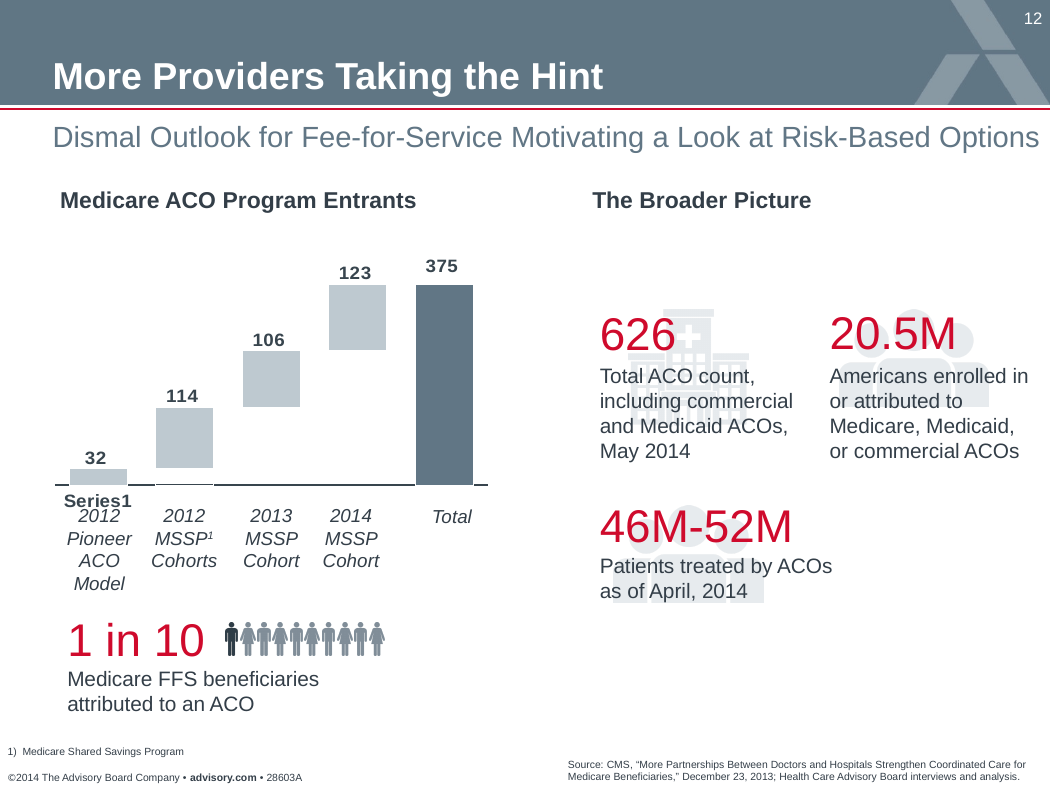
What type of chart is the Medicare ACO Program Entrants chart? Bar chart In the Medicare ACO Program Entrants chart, what is the difference between the 2012 MSSP Cohorts value and the 2013 MSSP Cohort value? 8 In the Medicare ACO Program Entrants chart, which is larger: the 2012 MSSP Cohorts value or the 2013 MSSP Cohort value? 2012 MSSP Cohorts In the Medicare ACO Program Entrants chart, what is the value for the 2012 Pioneer ACO Model? 32 In the Medicare ACO Program Entrants chart, what is the value for the 2013 MSSP Cohort? 106 How many bars are plotted in the Medicare ACO Program Entrants chart, including the Total bar? 5 In the Medicare ACO Program Entrants chart, what is the difference between the 2014 MSSP Cohort value and the 2012 Pioneer ACO Model value? 91 What is the title of the chart on the left side of the slide? Medicare ACO Program Entrants In the Medicare ACO Program Entrants chart, what is the value for the 2014 MSSP Cohort? 123 In the Medicare ACO Program Entrants chart, which of the four cohort categories (excluding Total) has the highest value? 2014 MSSP Cohort In the Medicare ACO Program Entrants chart, what is the value shown for Total? 375 In the Medicare ACO Program Entrants chart, which category has the lowest value? 2012 Pioneer ACO Model